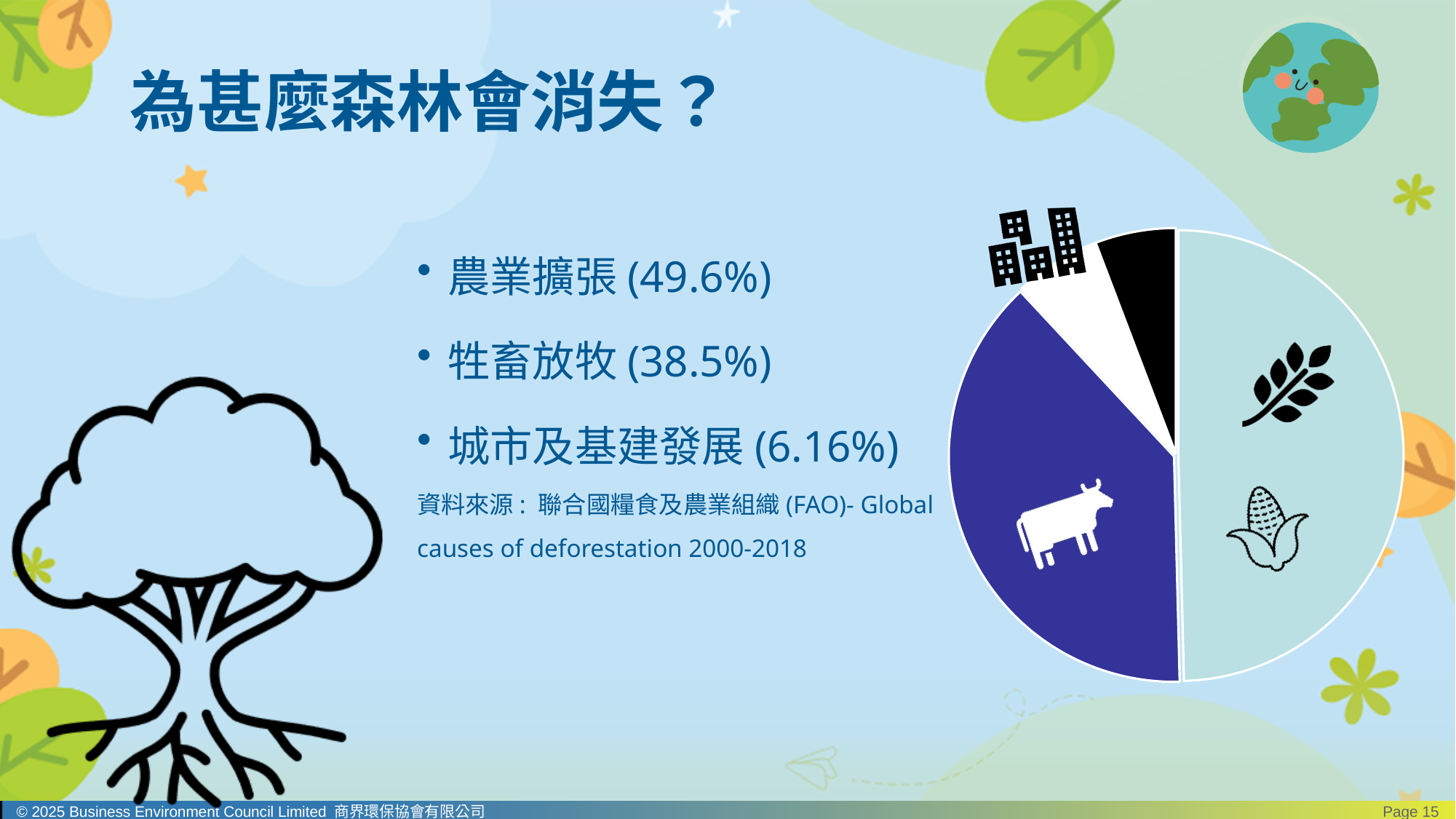
How many slices does the pie chart contain? 4 What share of deforestation is attributed to 城市及基建發展 (urban and infrastructure development)? 6.16% What data source is cited for the chart? 聯合國糧食及農業組織 (FAO)- Global causes of deforestation 2000-2018 Which of the three labelled causes has the smallest share? 城市及基建發展 What kind of chart is shown on the slide? pie chart What share of deforestation is attributed to 農業擴張 (agricultural expansion)? 49.6% What is the combined share of 農業擴張 and 牲畜放牧? 88.1% Which colour is the slice representing 牲畜放牧 (the slice with the cow icon)? dark blue What is the difference in share between 農業擴張 and 牲畜放牧? 11.1% Which is larger, the share for 牲畜放牧 or the share for 城市及基建發展? 牲畜放牧 What share of deforestation is attributed to 牲畜放牧 (livestock grazing)? 38.5% Which cause of deforestation has the largest share in the pie chart? 農業擴張